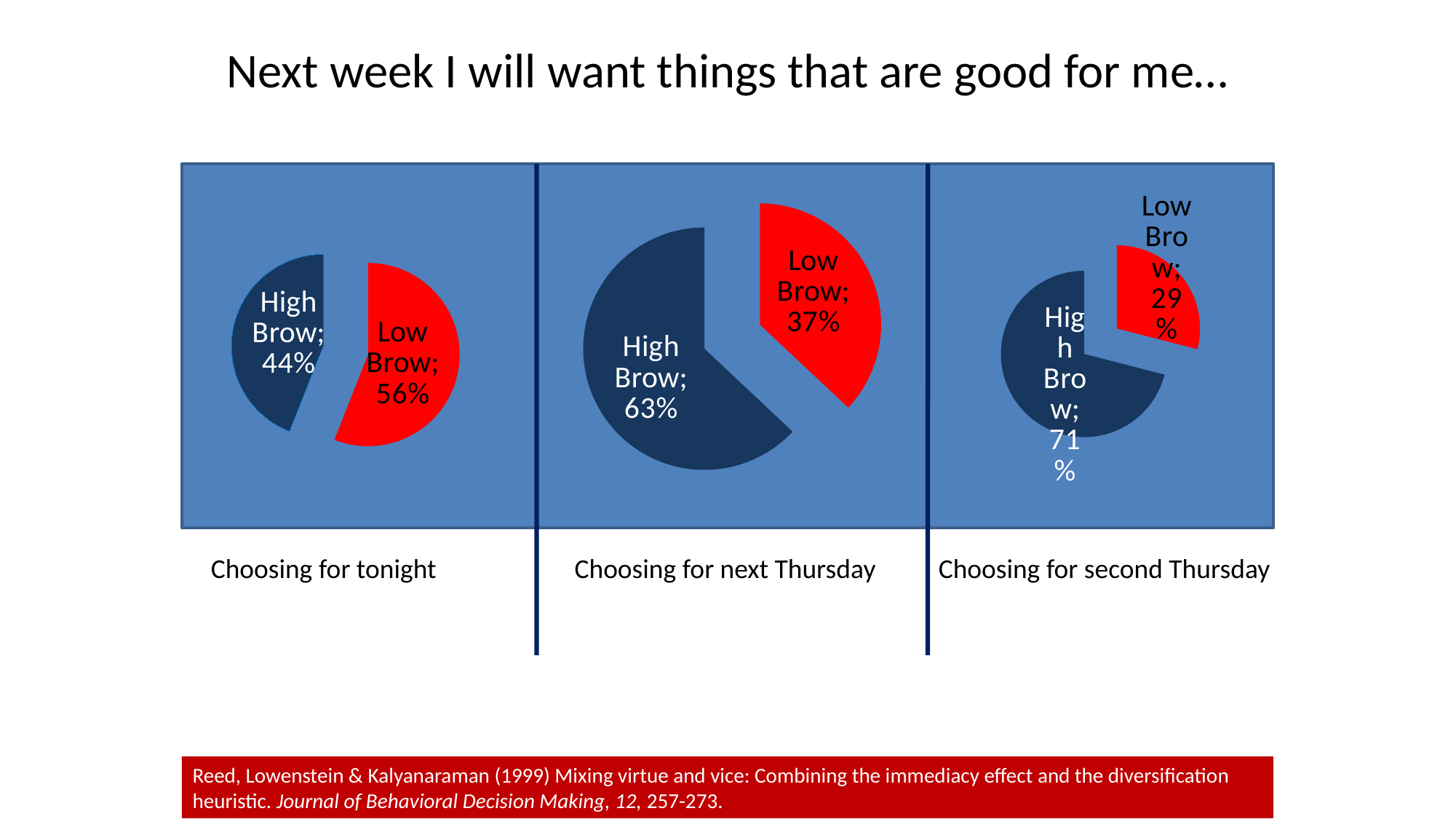
In the 'Choosing for tonight' chart, which slice is larger, High Brow or Low Brow? Low Brow In the 'Choosing for second Thursday' chart, which slice is the largest? High Brow In the 'Choosing for tonight' chart, what percentage is High Brow? 44% What kind of chart is used in each of the three panels on the slide? Pie chart In the 'Choosing for next Thursday' chart, what is the difference between the High Brow and Low Brow percentages? 26% In the 'Choosing for second Thursday' chart, what percentage is High Brow? 71% Across the three charts from left to right, does the High Brow percentage rise or fall? Rise In the 'Choosing for second Thursday' chart, what percentage is Low Brow? 29% In the 'Choosing for next Thursday' chart, what percentage is High Brow? 63% How many slices does the 'Choosing for tonight' pie chart have? 2 In the 'Choosing for tonight' chart, what percentage is Low Brow? 56% In the 'Choosing for next Thursday' chart, what percentage is Low Brow? 37%